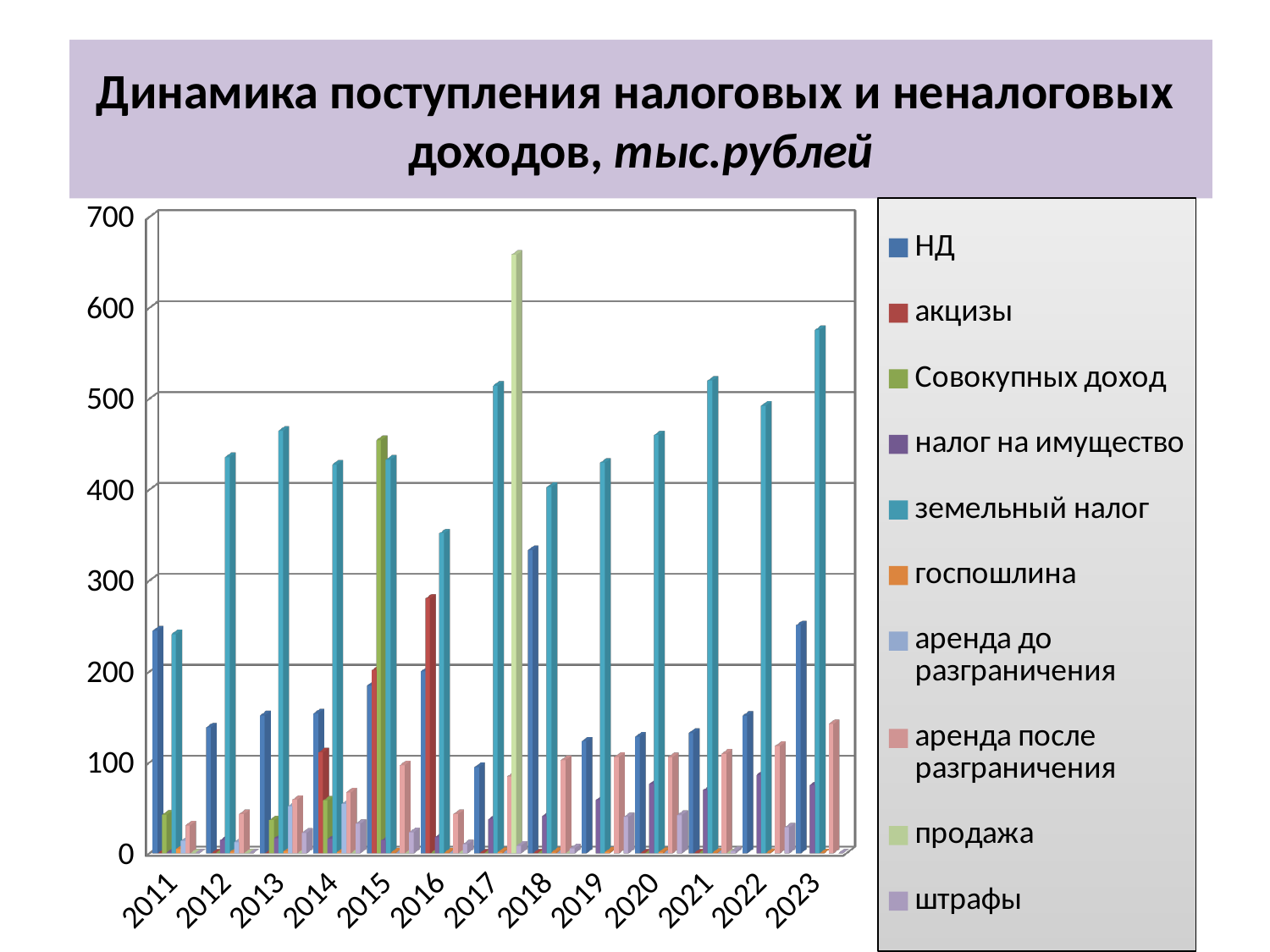
In which year is the value for НД the highest? 2018 In which year is the value for земельный налог the lowest? 2011 What kind of chart is shown on the slide? bar chart Is the value for земельный налог in 2016 greater or less than 400? less In which year is the value for земельный налог the highest? 2023 Which series is listed first in the legend? НД Is the value for земельный налог in 2023 greater or less than 500? greater How many series does the legend list? 10 Is the value for продажа in 2017 greater or less than 600? greater How many years are shown along the x axis of the chart? 13 In 2017, which is larger: продажа or земельный налог? продажа